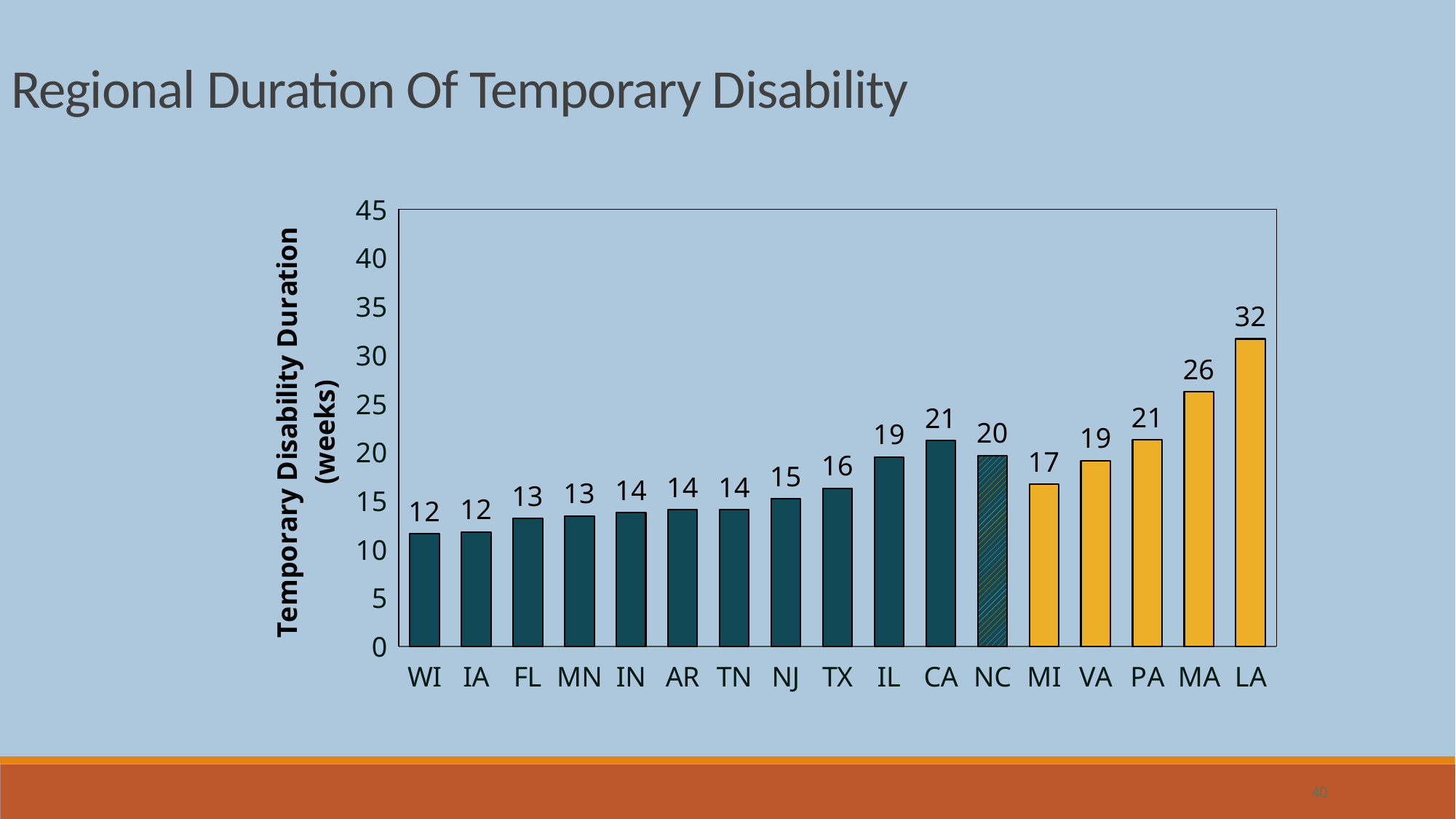
What is the difference in temporary disability duration between CA and WI? 9 How many states are shown on the x axis? 17 Is the value for MA greater or less than 25? greater What is the temporary disability duration for LA? 32 What is the difference in temporary disability duration between LA and MA? 6 What is the temporary disability duration for NC? 20 What kind of chart is shown on the slide? Bar chart What is the temporary disability duration for TX? 16 What is the label of the y axis? Temporary Disability Duration (weeks) Which state has the highest temporary disability duration? LA Which has a longer temporary disability duration, MI or PA? PA What is the title of the slide? Regional Duration Of Temporary Disability